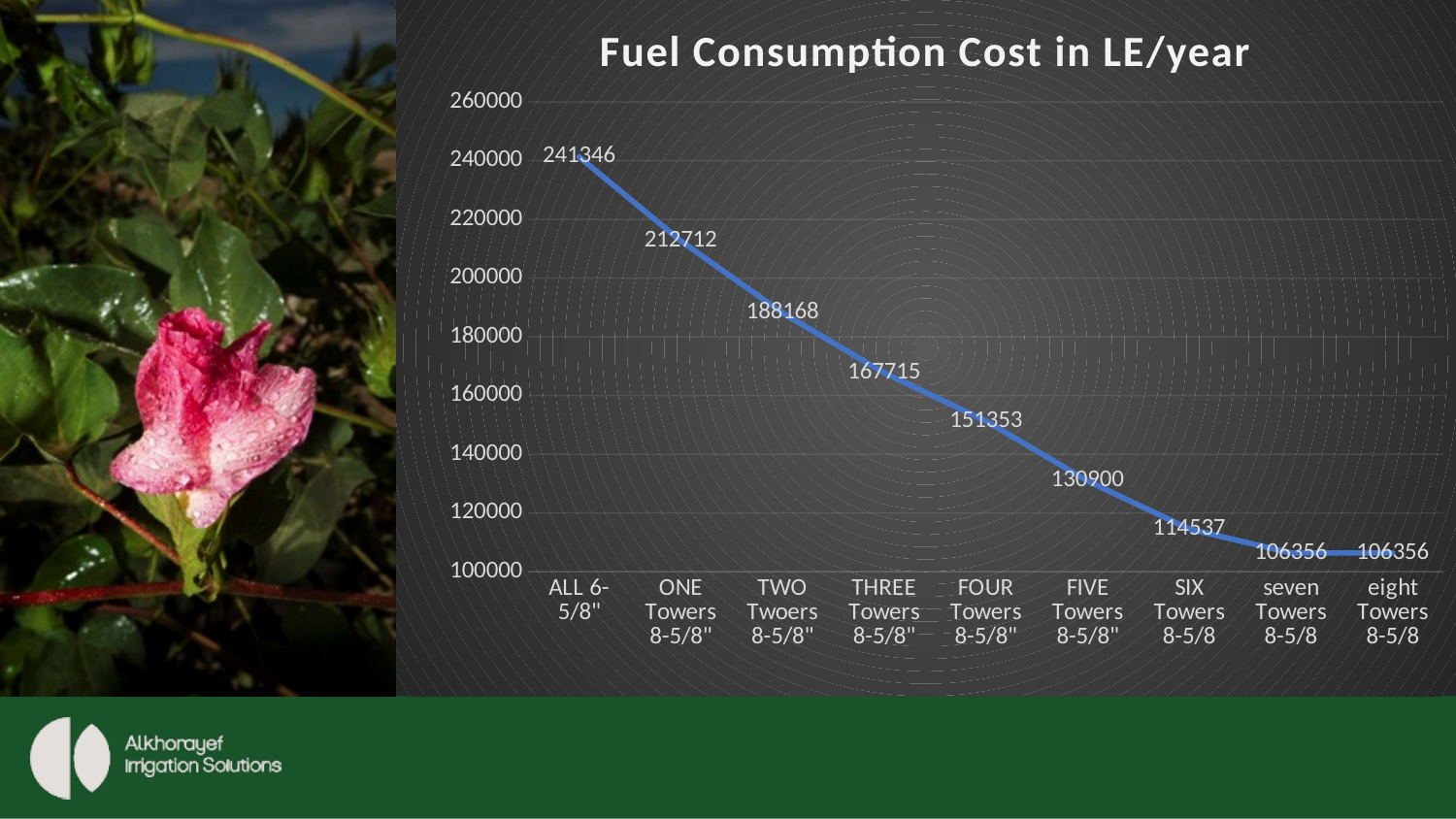
What is the fuel consumption cost for SIX Towers 8-5/8? 114537 What kind of chart is shown on the slide? line chart Is the fuel consumption cost for FOUR Towers 8-5/8" greater or less than 160000? less What is the difference in fuel consumption cost between ALL 6-5/8" and ONE Towers 8-5/8"? 28634 Which category has the highest fuel consumption cost? ALL 6-5/8" What is the fuel consumption cost for ALL 6-5/8"? 241346 What is the lowest fuel consumption cost shown on the chart? 106356 What is the fuel consumption cost for THREE Towers 8-5/8"? 167715 Do the values rise or fall from left to right along the x axis? fall Which has a higher fuel consumption cost, TWO Twoers 8-5/8" or FIVE Towers 8-5/8"? TWO Twoers 8-5/8" What is the difference in fuel consumption cost between FOUR Towers 8-5/8" and FIVE Towers 8-5/8"? 20453 How many categories are plotted on the x axis? 9